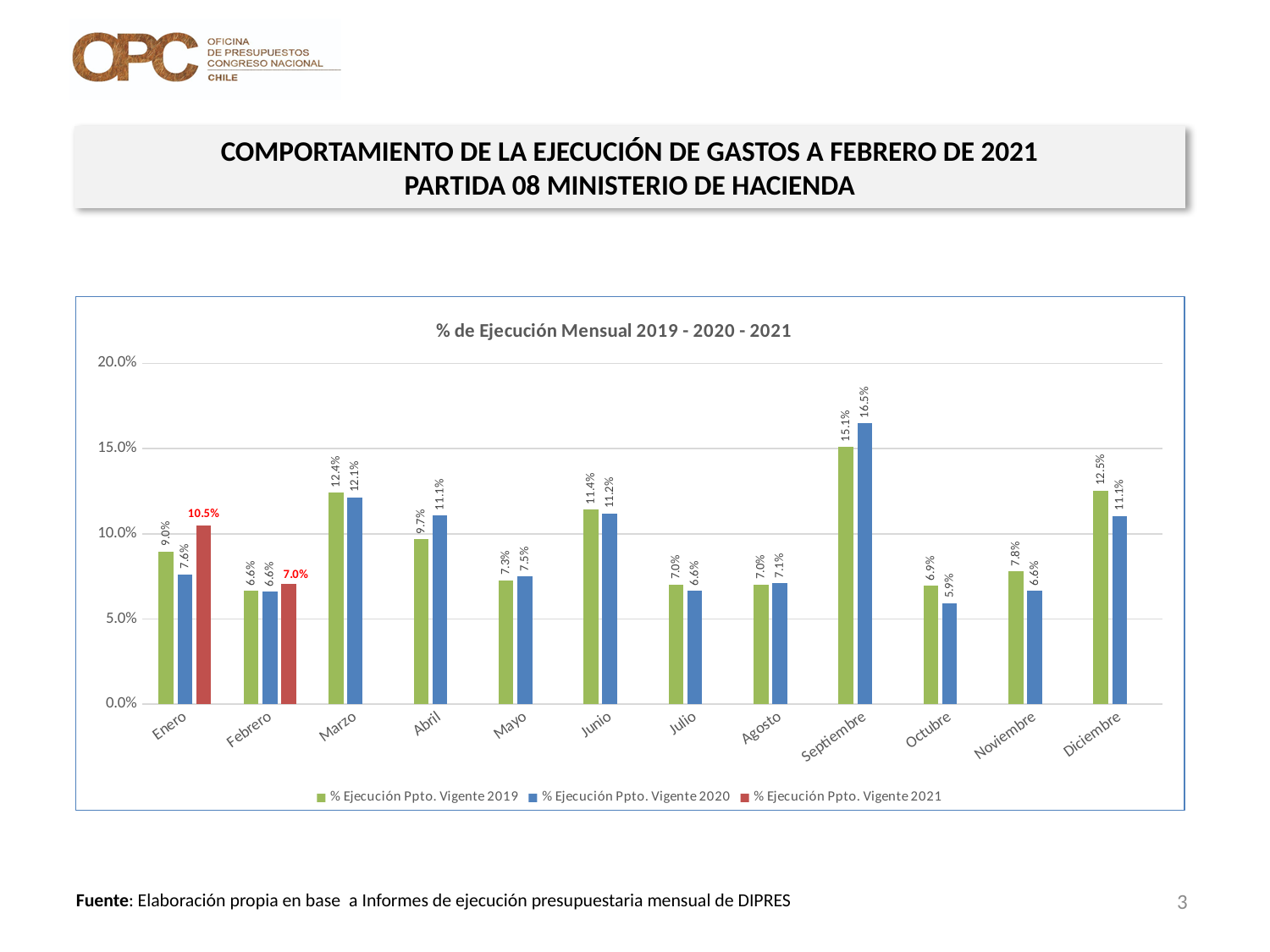
What is the value for % Ejecución Ppto. Vigente 2020 in Septiembre? 16.5% Which month has the highest value for % Ejecución Ppto. Vigente 2019? Septiembre What is the difference between the 2020 and 2019 values in Septiembre? 1.4% Which month has the lowest value for % Ejecución Ppto. Vigente 2020? Octubre In Abril, which series has the larger value, 2019 or 2020? % Ejecución Ppto. Vigente 2020 What type of chart is shown? Bar chart In Diciembre, which series has the larger value, 2019 or 2020? % Ejecución Ppto. Vigente 2019 What is the difference between the 2021 and 2020 values in Enero? 2.9% How many months are shown on the x axis? 12 What is the value for % Ejecución Ppto. Vigente 2019 in Marzo? 12.4% How many series does the legend list? 3 What is the value for % Ejecución Ppto. Vigente 2021 in Enero? 10.5%